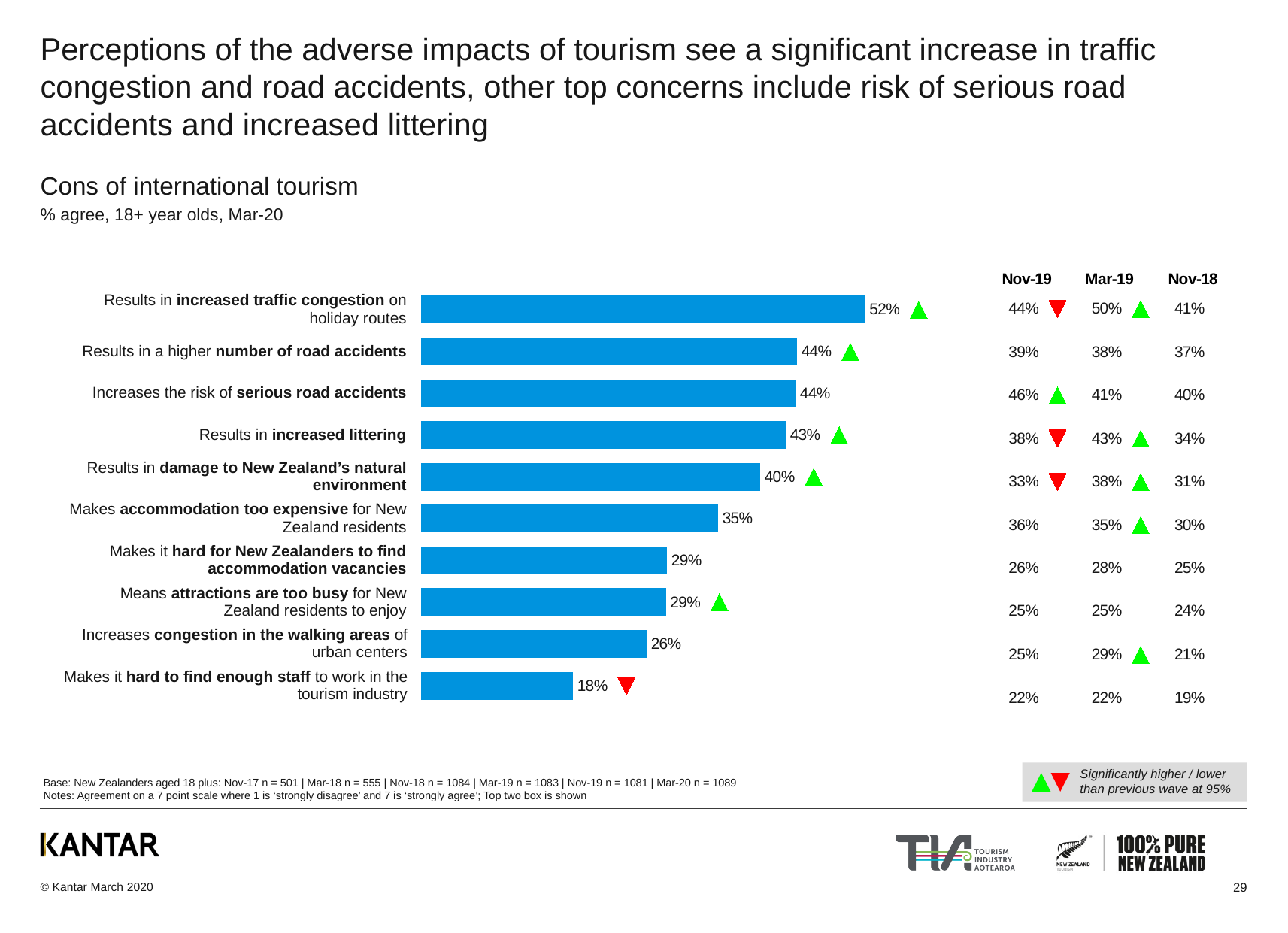
What is the difference in percentage points between 'Results in damage to New Zealand's natural environment' and 'Makes accommodation too expensive for New Zealand residents'? 5 percentage points What is the subtitle describing the measure shown in the chart? % agree, 18+ year olds, Mar-20 Which has a higher percentage agreeing: 'Makes accommodation too expensive for New Zealand residents' or 'Increases congestion in the walking areas of urban centers'? Makes accommodation too expensive for New Zealand residents How many cons of international tourism are plotted in the chart? 10 What is the difference in percentage points between 'Results in increased traffic congestion on holiday routes' and 'Makes it hard to find enough staff to work in the tourism industry'? 34 percentage points Which con of international tourism has the highest percentage agreeing? Results in increased traffic congestion on holiday routes What colour are the bars in the chart? Blue What percentage agree that international tourism makes it hard to find enough staff to work in the tourism industry? 18% What percentage agree that international tourism results in increased littering? 43% What percentage agree that international tourism results in increased traffic congestion on holiday routes? 52% What kind of chart is used to show the cons of international tourism? Bar chart Which con of international tourism has the lowest percentage agreeing? Makes it hard to find enough staff to work in the tourism industry